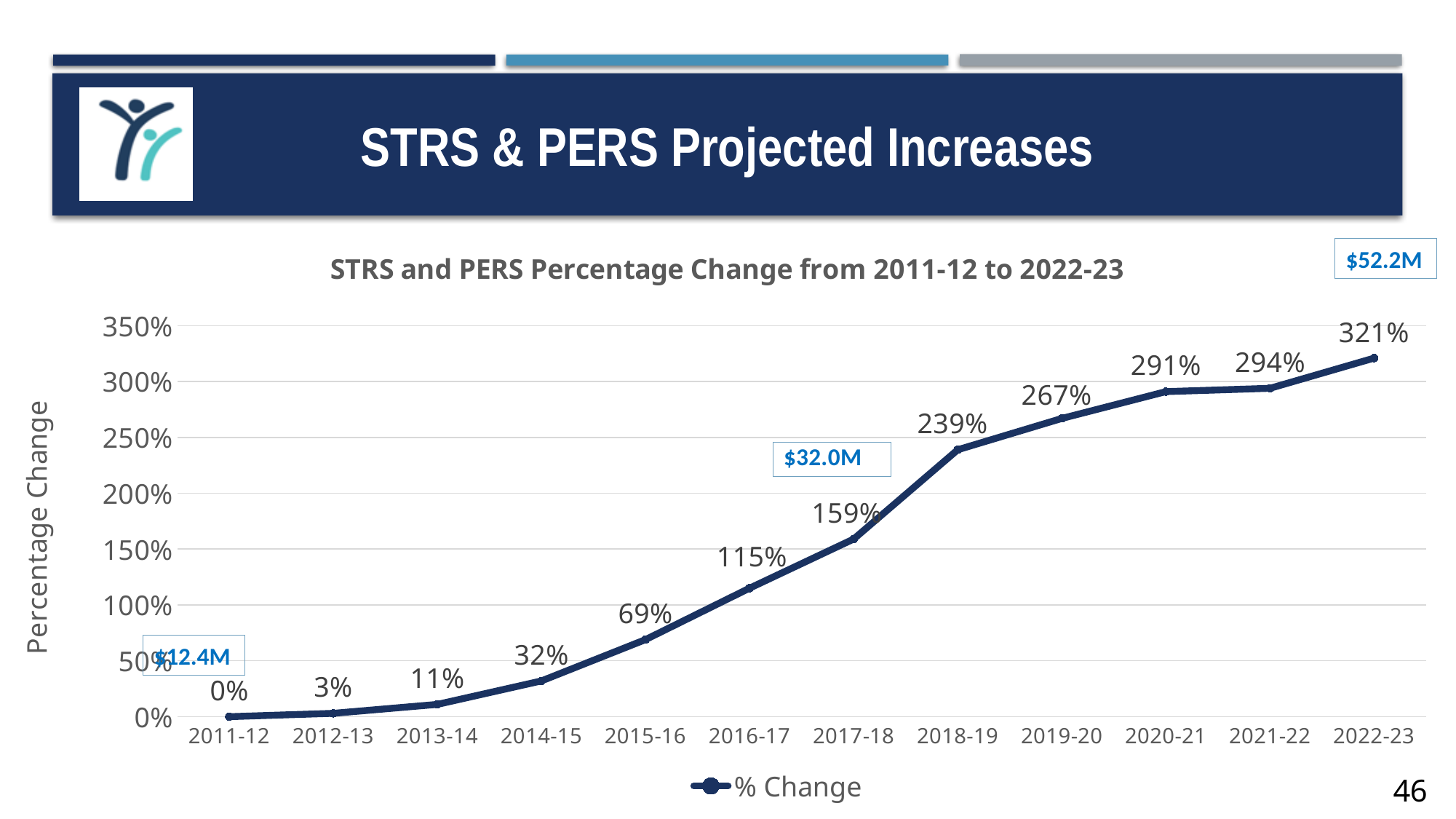
What is the % Change value for 2015-16? 69% What is the % Change value for 2018-19? 239% What is the difference in % Change between 2022-23 and 2021-22? 27% How many years are plotted on the x axis? 12 What is the difference in % Change between 2018-19 and 2017-18? 80% Do the % Change values rise or fall from 2011-12 to 2022-23? Rise Which year has the highest % Change? 2022-23 How many series does the legend list? 1 Which is larger, the % Change for 2016-17 or for 2014-15? 2016-17 Which year has the lowest % Change? 2011-12 What kind of chart is shown on the slide? Line chart What is the % Change value for 2022-23? 321%